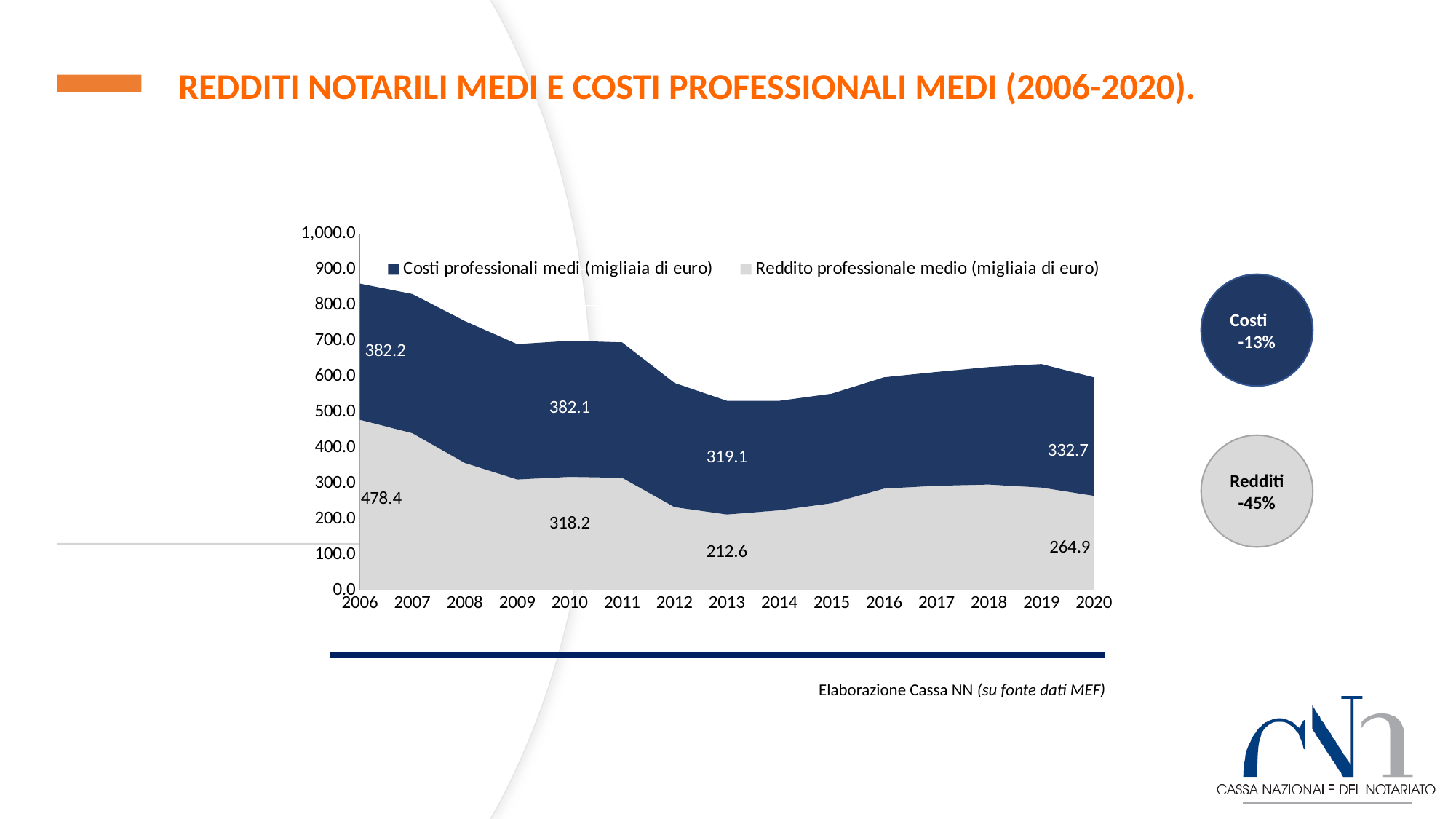
In 2020, which is larger: Costi professionali medi or Reddito professionale medio? Costi professionali medi How many years are shown on the x axis of the chart? 15 What is the value of Costi professionali medi (migliaia di euro) in 2010? 382.1 What is the combined total of Costi professionali medi and Reddito professionale medio in 2013? 531.7 By how much did Reddito professionale medio fall from 2006 to 2020, based on the printed labels? 213.5 What is the value of Reddito professionale medio (migliaia di euro) in 2013? 212.6 How many series does the chart legend list? 2 What is the value of Costi professionali medi (migliaia di euro) in 2020? 332.7 What kind of chart is shown on the slide? Stacked area chart In 2006, which is larger: Costi professionali medi or Reddito professionale medio? Reddito professionale medio Is the value of Reddito professionale medio in 2009 greater or less than 400? less What is the value of Reddito professionale medio (migliaia di euro) in 2006? 478.4